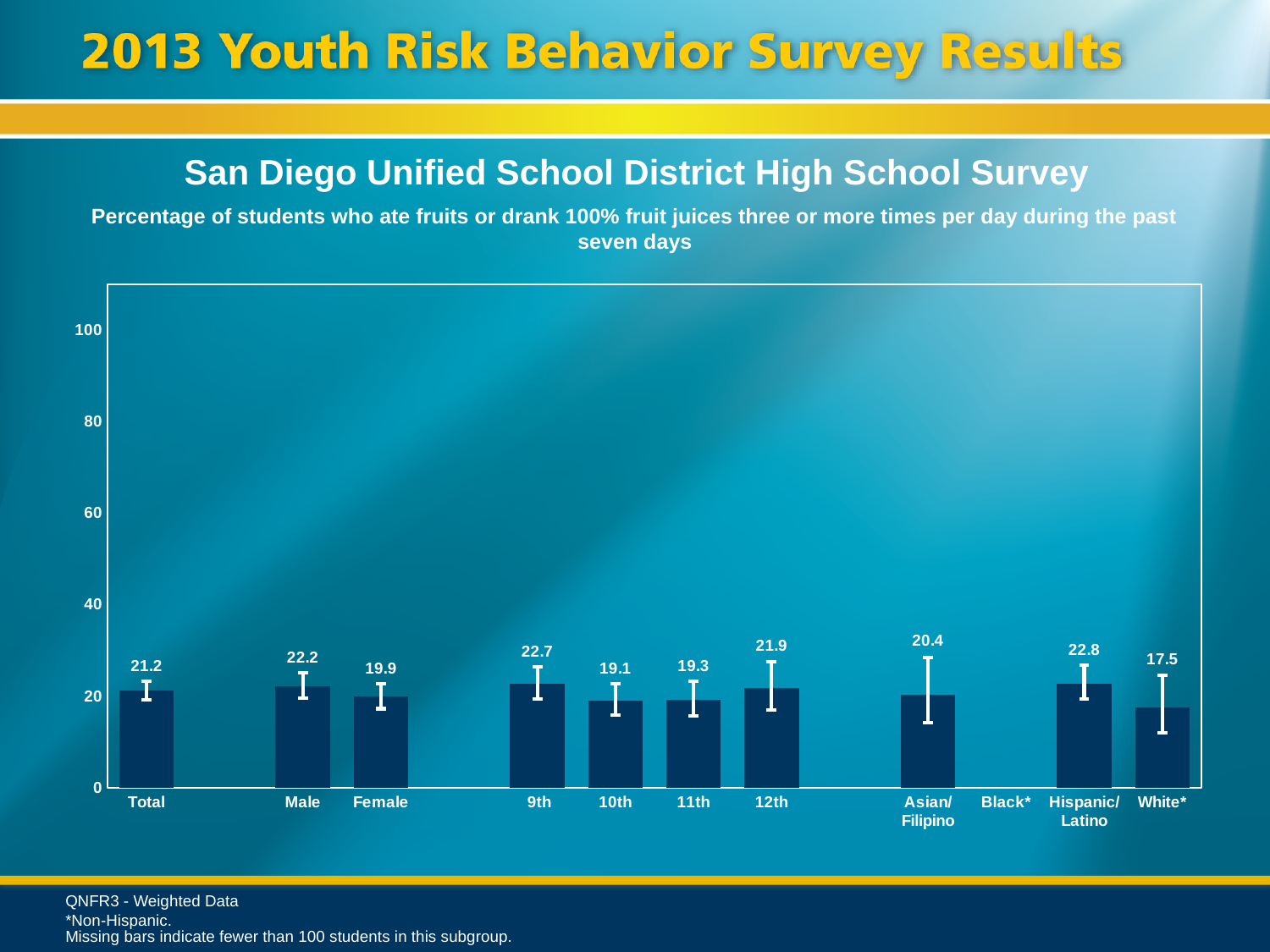
What is the value for 12th? 21.9 What is the value for Asian/Filipino? 20.4 What is the difference between the values for Male and Female? 2.3 What is the value for Total? 21.2 What is the value for Female? 19.9 Which category has the highest value? Hispanic/Latino Which category has no bar shown? Black* How many categories are labeled on the x axis? 11 Which is larger, the value for 9th or the value for 10th? 9th Is the value for 11th greater or less than 40? less What kind of chart is shown? bar chart Which category has the lowest value among those with bars? White*